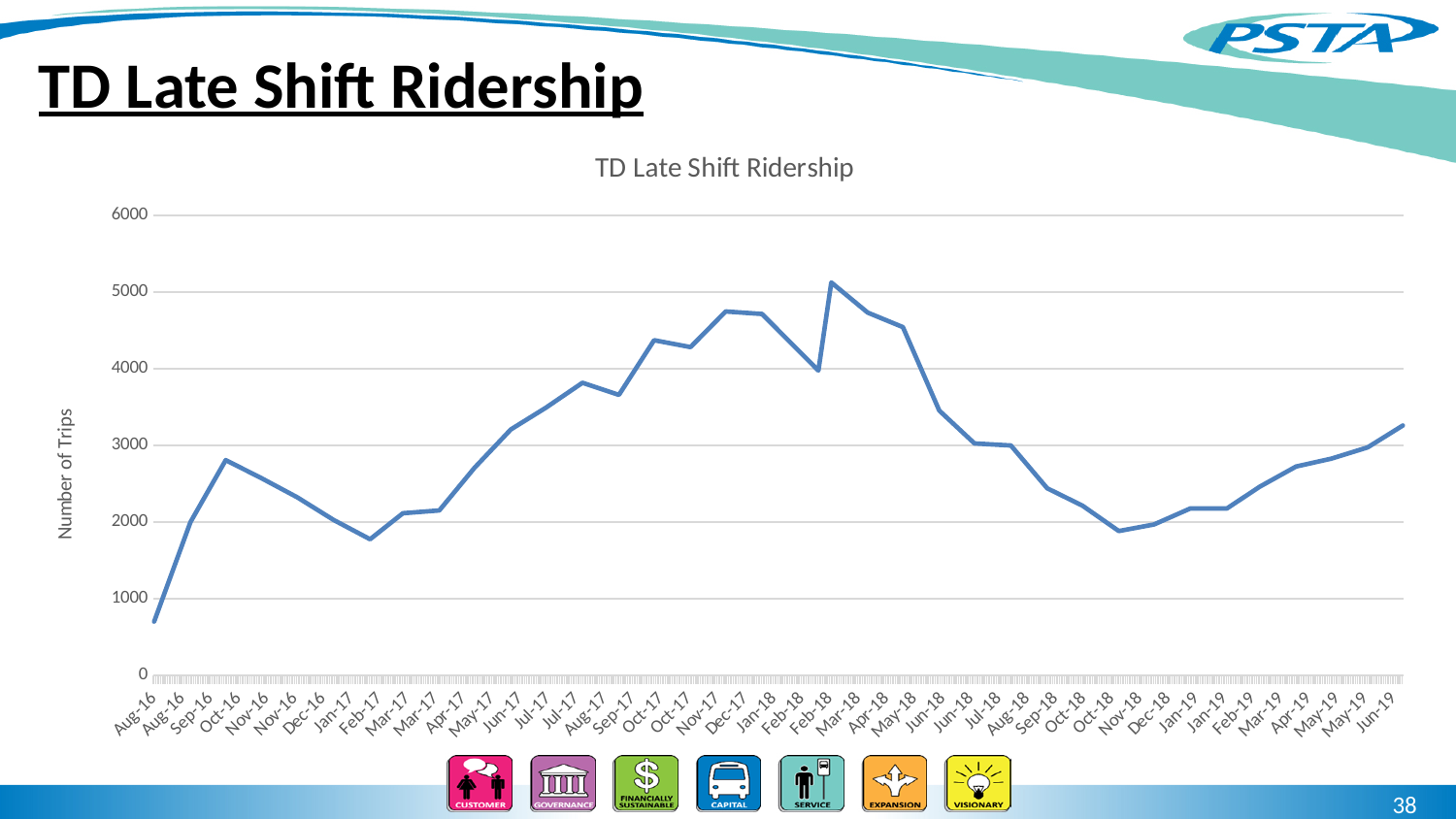
Does the number of trips rise or fall from Aug-16 to Oct-16? rise What type of chart is shown on the slide? line chart Is the value for Aug-16, the first point on the chart, greater or less than 1000? less Which is larger, the value for Aug-16 or the value for Jun-19? Jun-19 What is the highest value shown on the vertical axis? 6000 What is the title of the chart? TD Late Shift Ridership Which month has the lowest number of trips on the chart? Aug-16 Does the number of trips rise or fall from Nov-18 to Jun-19? rise Is the highest point on the chart greater or less than 5000? greater Is the value for Feb-17 greater or less than 2000? less What is the label on the vertical axis of the chart? Number of Trips